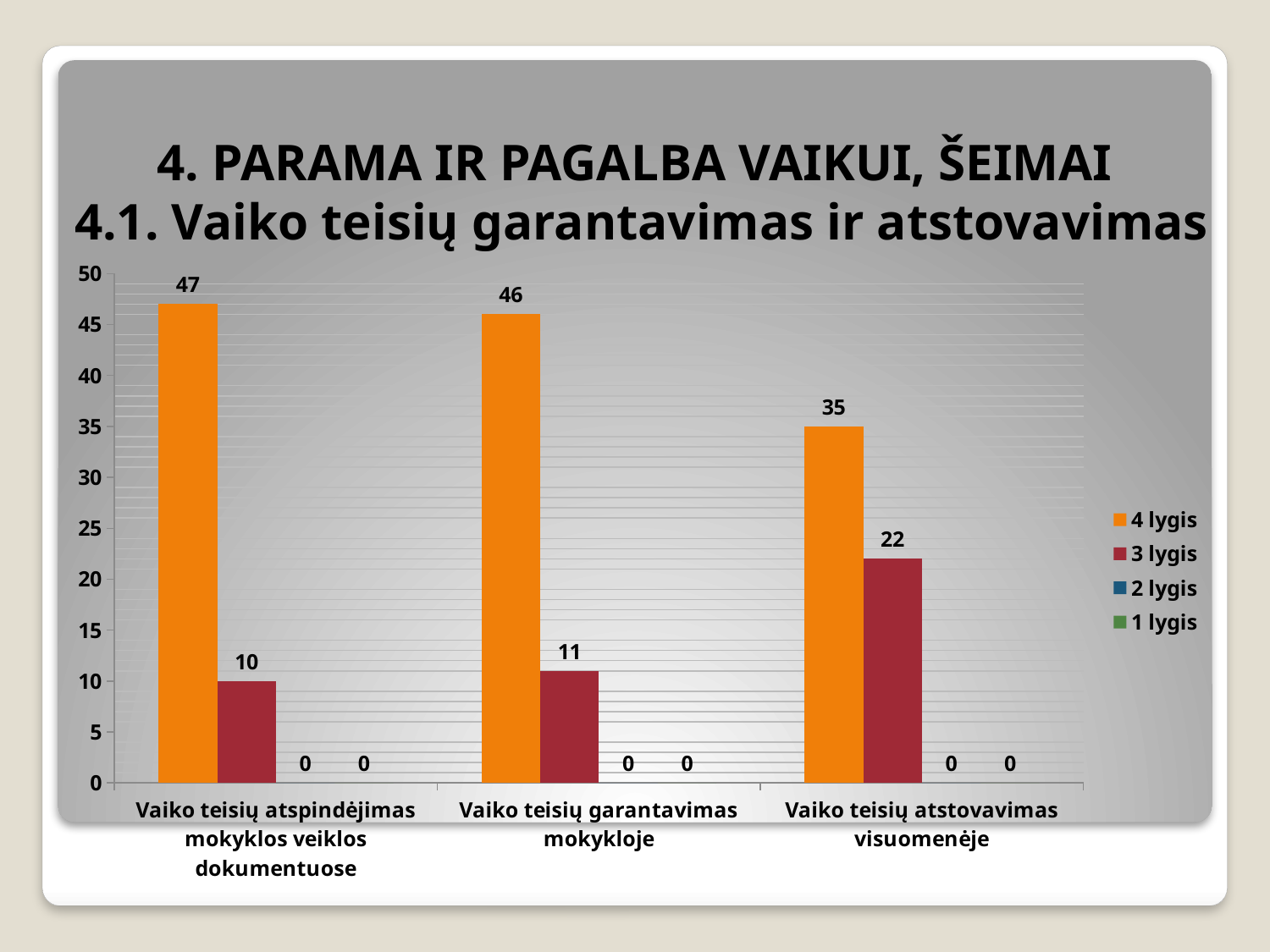
How many series does the legend list? 4 Which is larger: the "3 lygis" value for "Vaiko teisių atspindėjimas mokyklos veiklos dokumentuose" or for "Vaiko teisių atstovavimas visuomenėje"? Vaiko teisių atstovavimas visuomenėje What kind of chart is shown on the slide? Bar chart Which category has the lowest "4 lygis" value? Vaiko teisių atstovavimas visuomenėje How many categories are shown on the x axis? 3 Which category has the highest "4 lygis" value? Vaiko teisių atspindėjimas mokyklos veiklos dokumentuose What is the value of "3 lygis" for "Vaiko teisių atstovavimas visuomenėje"? 22 What is the value of "3 lygis" for "Vaiko teisių garantavimas mokykloje"? 11 Do the "4 lygis" values rise or fall from left to right across the categories? Fall What is the difference between the "4 lygis" and "3 lygis" values for "Vaiko teisių atstovavimas visuomenėje"? 13 What is the value of "4 lygis" for "Vaiko teisių atspindėjimas mokyklos veiklos dokumentuose"? 47 What is the value of "2 lygis" for "Vaiko teisių garantavimas mokykloje"? 0